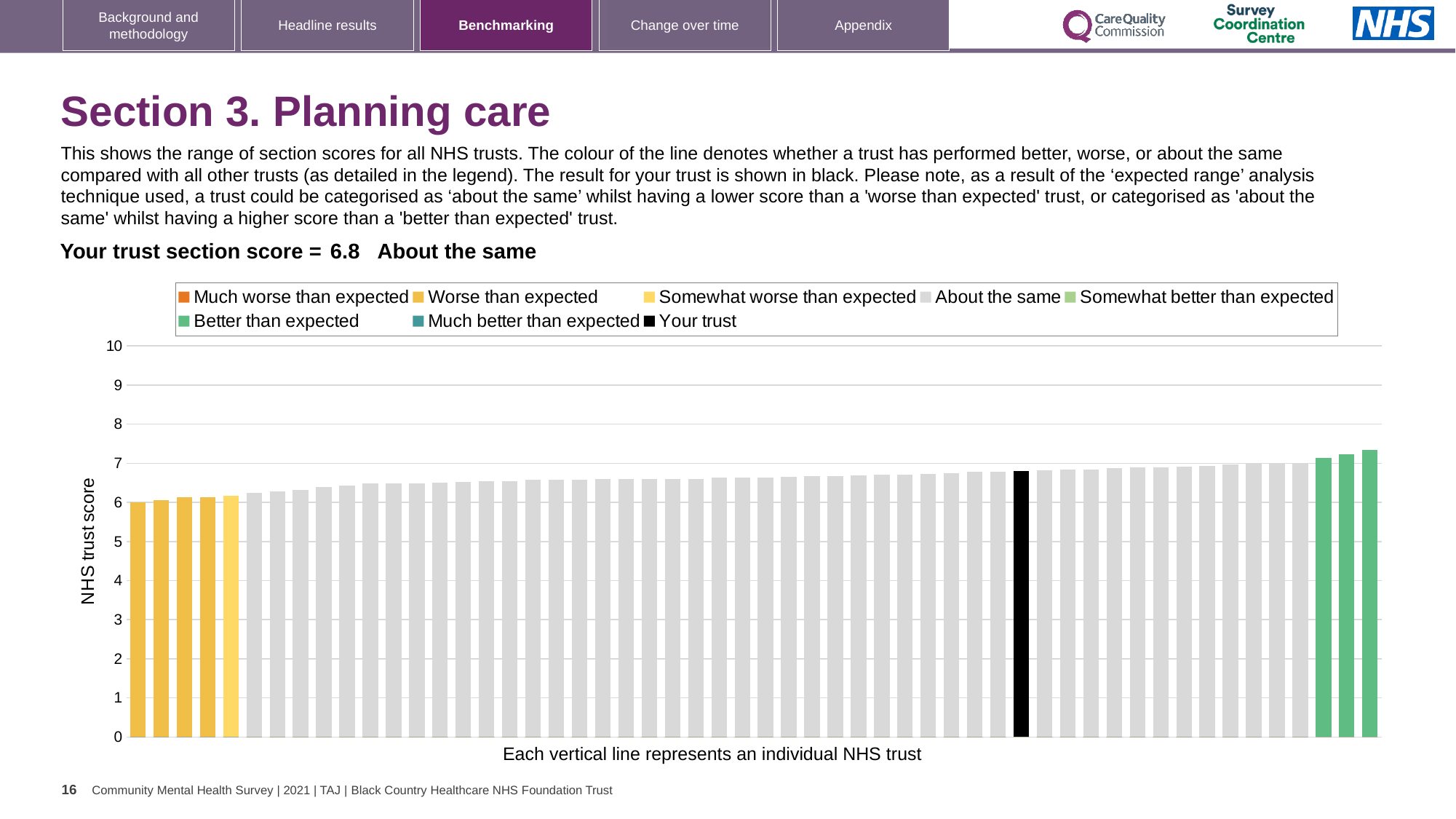
What is the section score for your trust shown on the slide? 6.8 How many entries does the chart legend list? 8 How many bars in the chart are coloured green (better than expected)? 3 What is the label on the vertical axis of the chart? NHS trust score Which benchmarking category is your trust placed in for Section 3. Planning care? About the same Is the value for your trust (the black bar) greater or less than 5? greater What is the highest value shown on the vertical axis? 10 Is the value of the shortest bar in the chart greater or less than 5? greater Is the value of the tallest bar in the chart greater or less than 8? less What kind of chart is shown on the slide? bar chart Do the bar values rise or fall from left to right along the x axis? rise What colour is used for the bar representing your trust? black